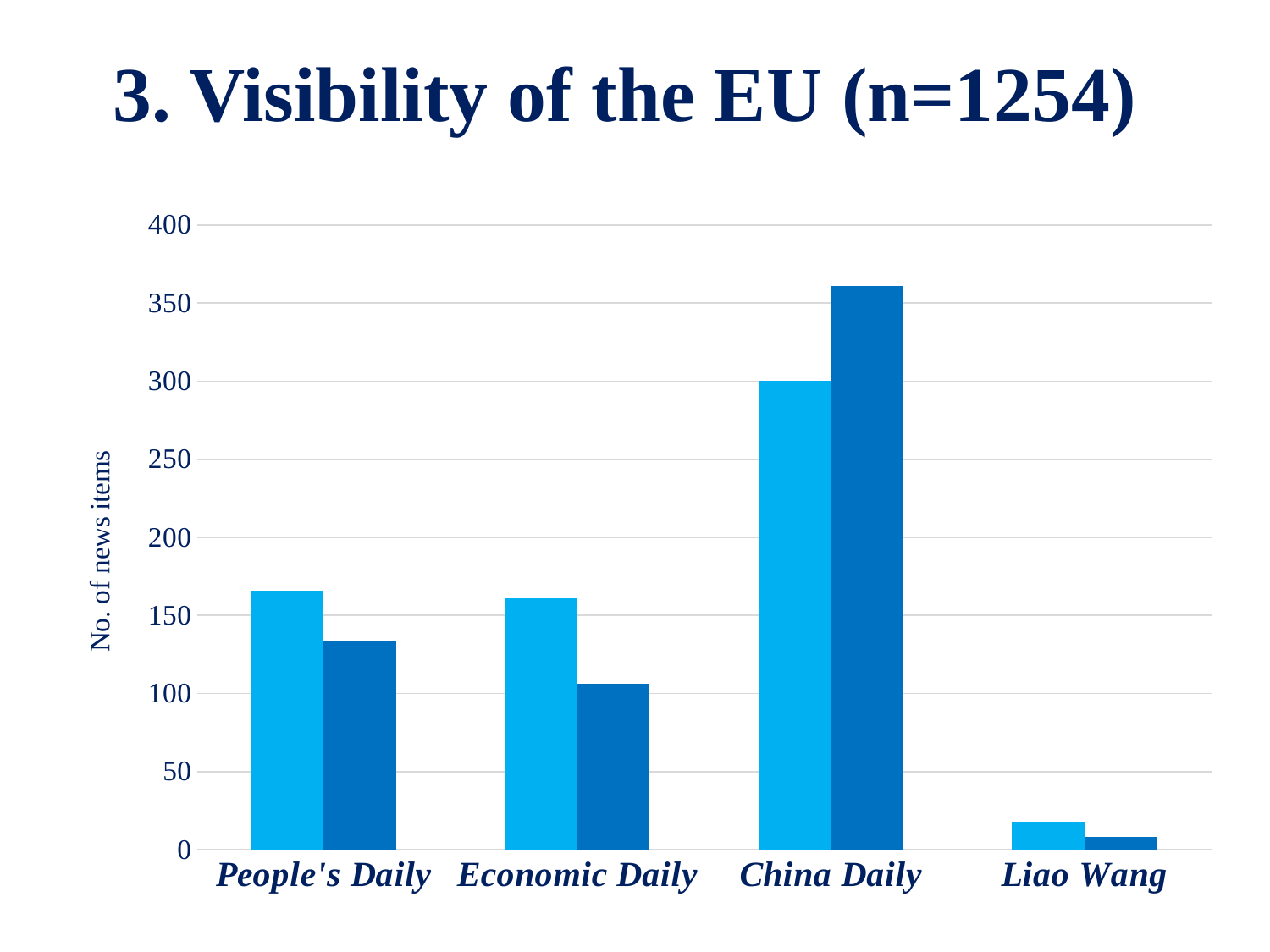
Which is larger, the dark blue bar for People's Daily or the dark blue bar for Economic Daily? People's Daily What is the label on the vertical axis? No. of news items Is the value of the light blue bar for People's Daily greater or less than 150? greater Is the value of the dark blue bar for People's Daily greater or less than 150? less For China Daily, which bar is taller, the light blue bar or the dark blue bar? the dark blue bar Which newspaper has the highest number of news items? China Daily What is the title of the chart? 3. Visibility of the EU (n=1254) Is the value of the light blue bar for Liao Wang greater or less than 50? less How many newspapers (categories) are shown on the x axis? 4 What kind of chart is shown on the slide? bar chart Which newspaper has the lowest number of news items? Liao Wang